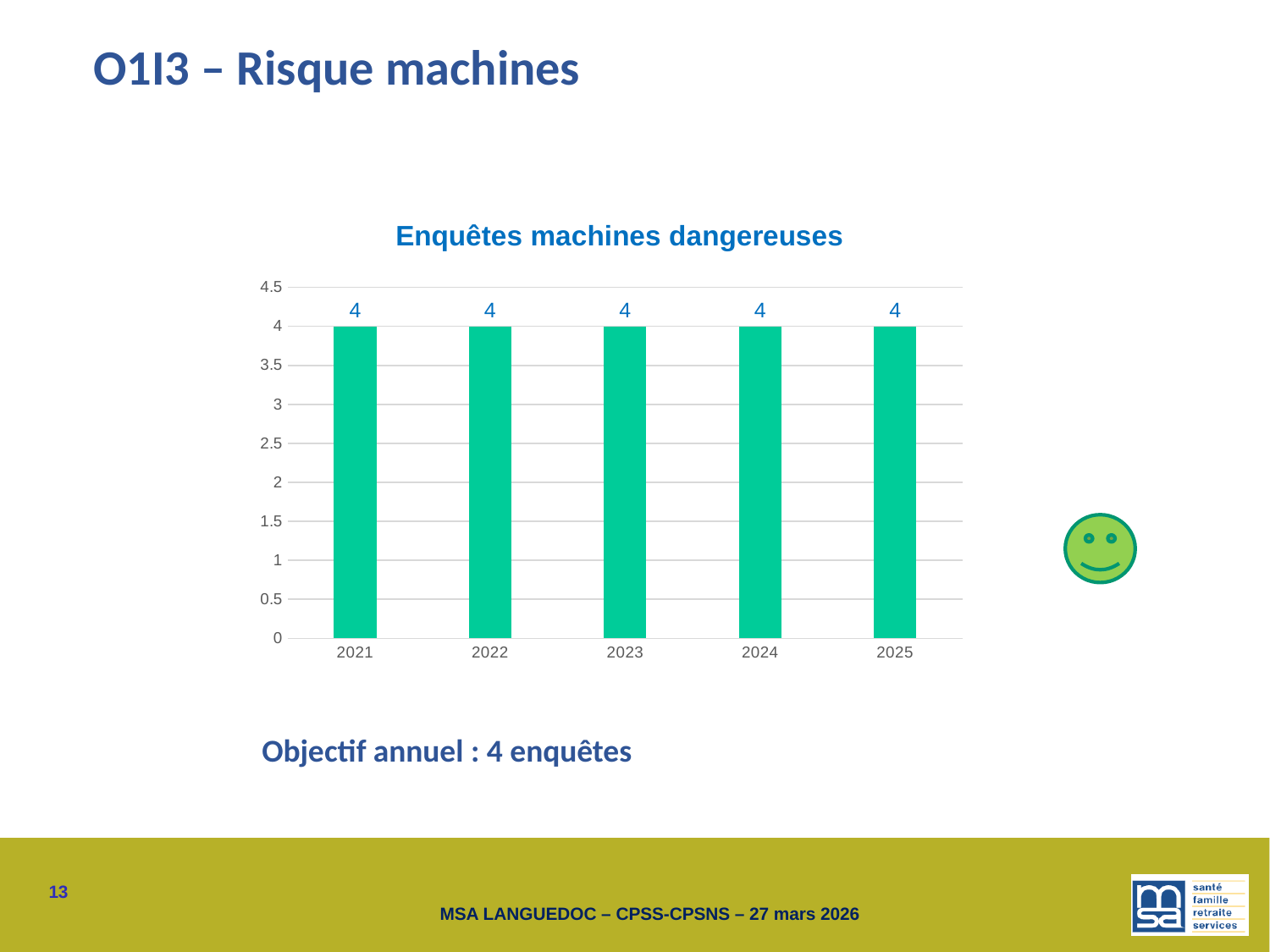
Is the value for 2022 greater or less than 3? greater What is the difference between the values for 2024 and 2022? 0 What is the highest value shown on the y axis of the chart? 4.5 What is the value for 2023 in the chart? 4 How many years are shown on the x axis of the chart? 5 Do the values rise, fall or stay the same from 2021 to 2025? stay the same What is the value for 2021 in the chart? 4 What is the title of the chart? Enquêtes machines dangereuses What kind of chart is shown on the slide? bar chart What is the value for 2025 in the chart? 4